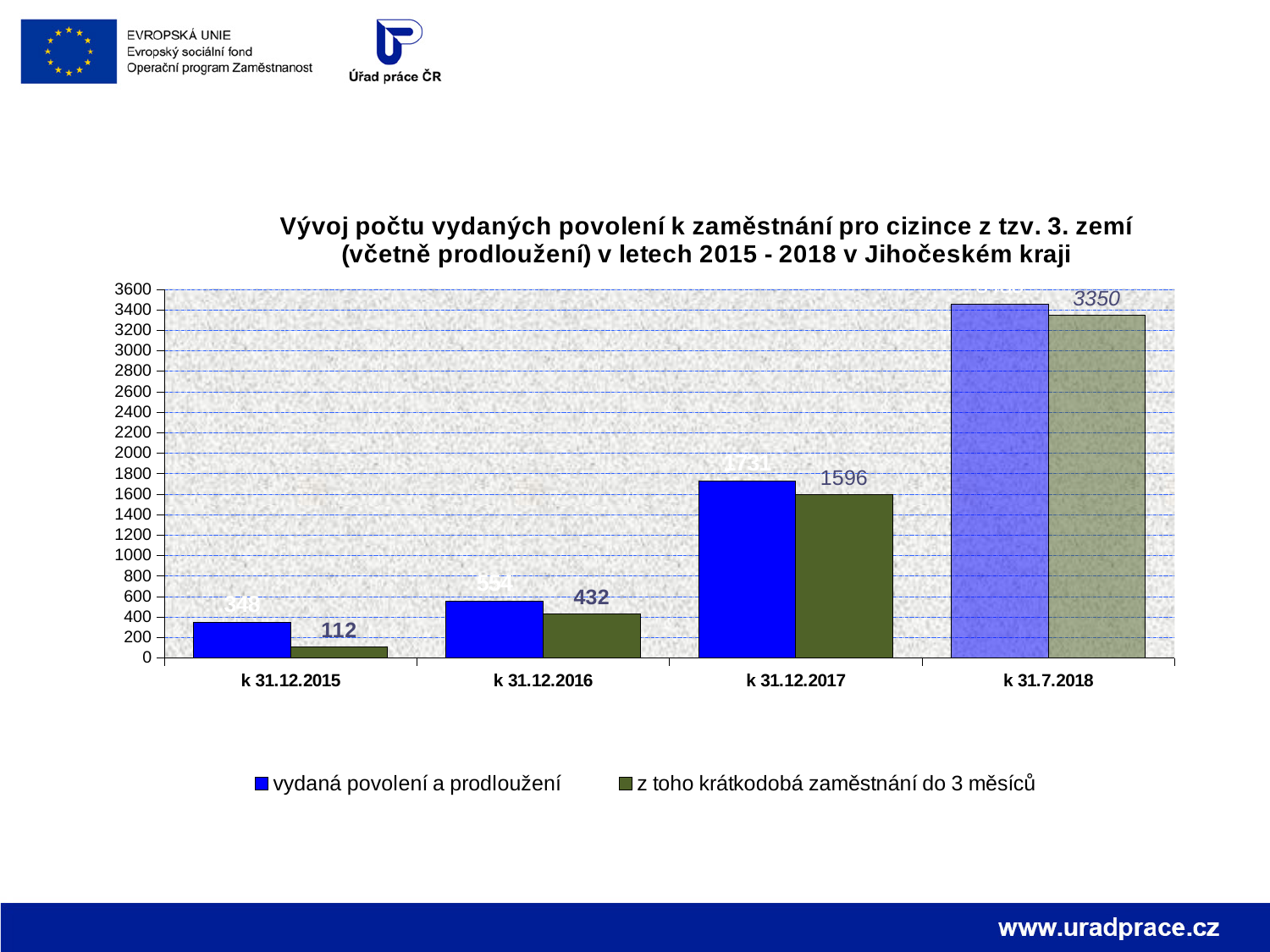
At which date is the 'z toho krátkodobá zaměstnání do 3 měsíců' value lowest? k 31.12.2015 By how much did 'z toho krátkodobá zaměstnání do 3 měsíců' increase from k 31.12.2016 to k 31.12.2017? 1164 At which date is the 'z toho krátkodobá zaměstnání do 3 měsíců' value highest? k 31.7.2018 What is the value for 'z toho krátkodobá zaměstnání do 3 měsíců' at k 31.12.2015? 112 How many series does the legend list? 2 Is the value for 'vydaná povolení a prodloužení' at k 31.7.2018 greater or less than 3000? greater Is the value for 'vydaná povolení a prodloužení' at k 31.12.2017 greater or less than 1400? greater What is the value for 'z toho krátkodobá zaměstnání do 3 měsíců' at k 31.7.2018? 3350 How many dates (categories) are shown on the x axis? 4 What is the difference between the 'z toho krátkodobá zaměstnání do 3 měsíců' values at k 31.7.2018 and k 31.12.2017? 1754 What is the value for 'z toho krátkodobá zaměstnání do 3 měsíců' at k 31.12.2017? 1596 What is the value for 'z toho krátkodobá zaměstnání do 3 měsíců' at k 31.12.2016? 432